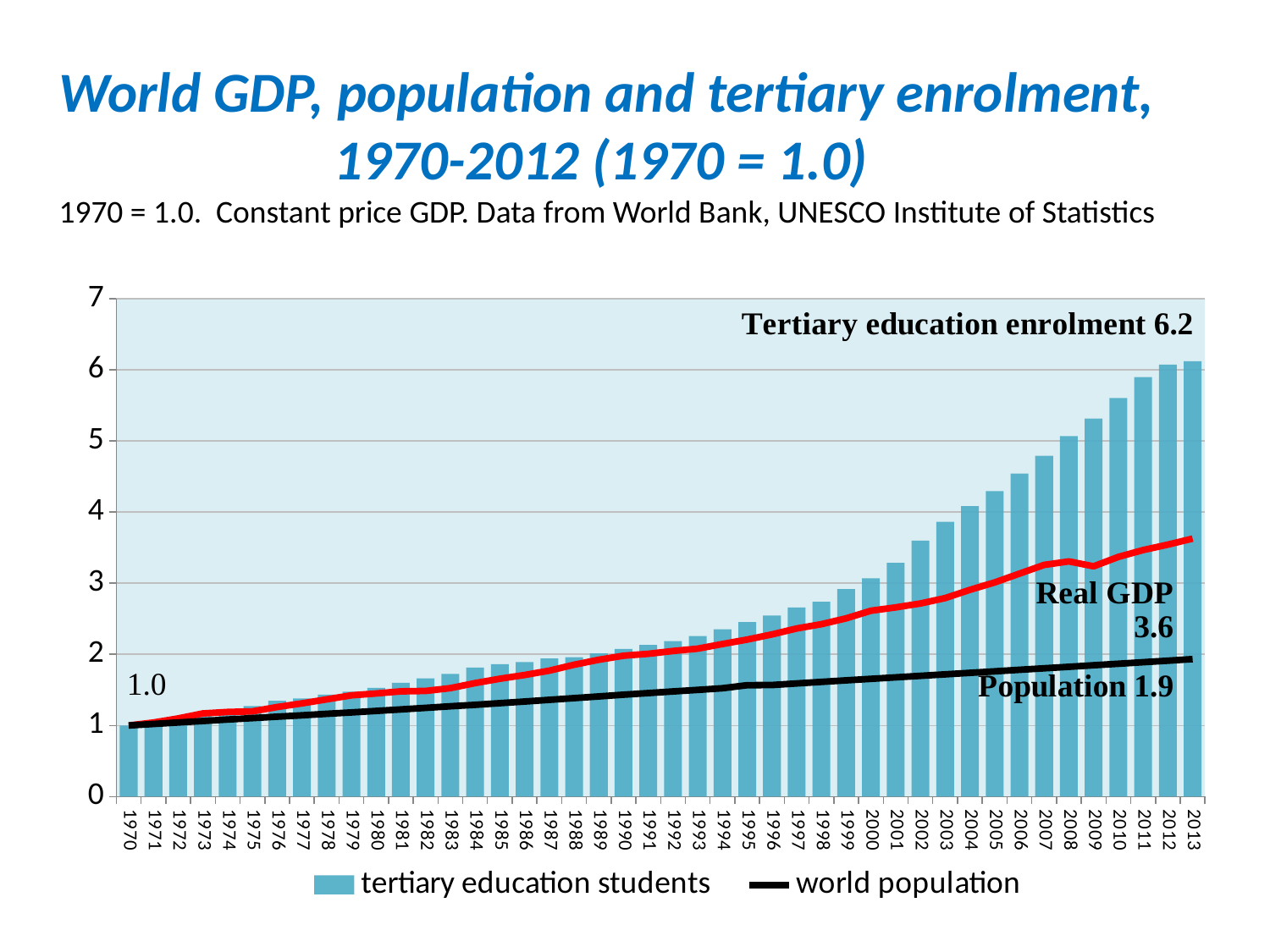
Which is larger at the end of the series: tertiary education enrolment or Real GDP? Tertiary education enrolment What is the value labelled for Population at the end of the series? 1.9 What is the title of the chart slide? World GDP, population and tertiary enrolment, 1970-2012 (1970 = 1.0) How many series does the legend list? 2 Do the tertiary education students bars rise or fall from 1970 to 2013? Rise What is the difference between the labelled tertiary education enrolment value (6.2) and the labelled Population value (1.9)? 4.3 Is the tertiary education students bar for 2007 greater or less than 4? greater Is the tertiary education students bar for 1980 greater or less than 2? less What value is labelled at the start of the series in 1970? 1.0 What is the value labelled for tertiary education enrolment at the end of the series? 6.2 What is the difference between the labelled Real GDP value (3.6) and the labelled Population value (1.9)? 1.7 What is the value labelled for Real GDP at the end of the series? 3.6